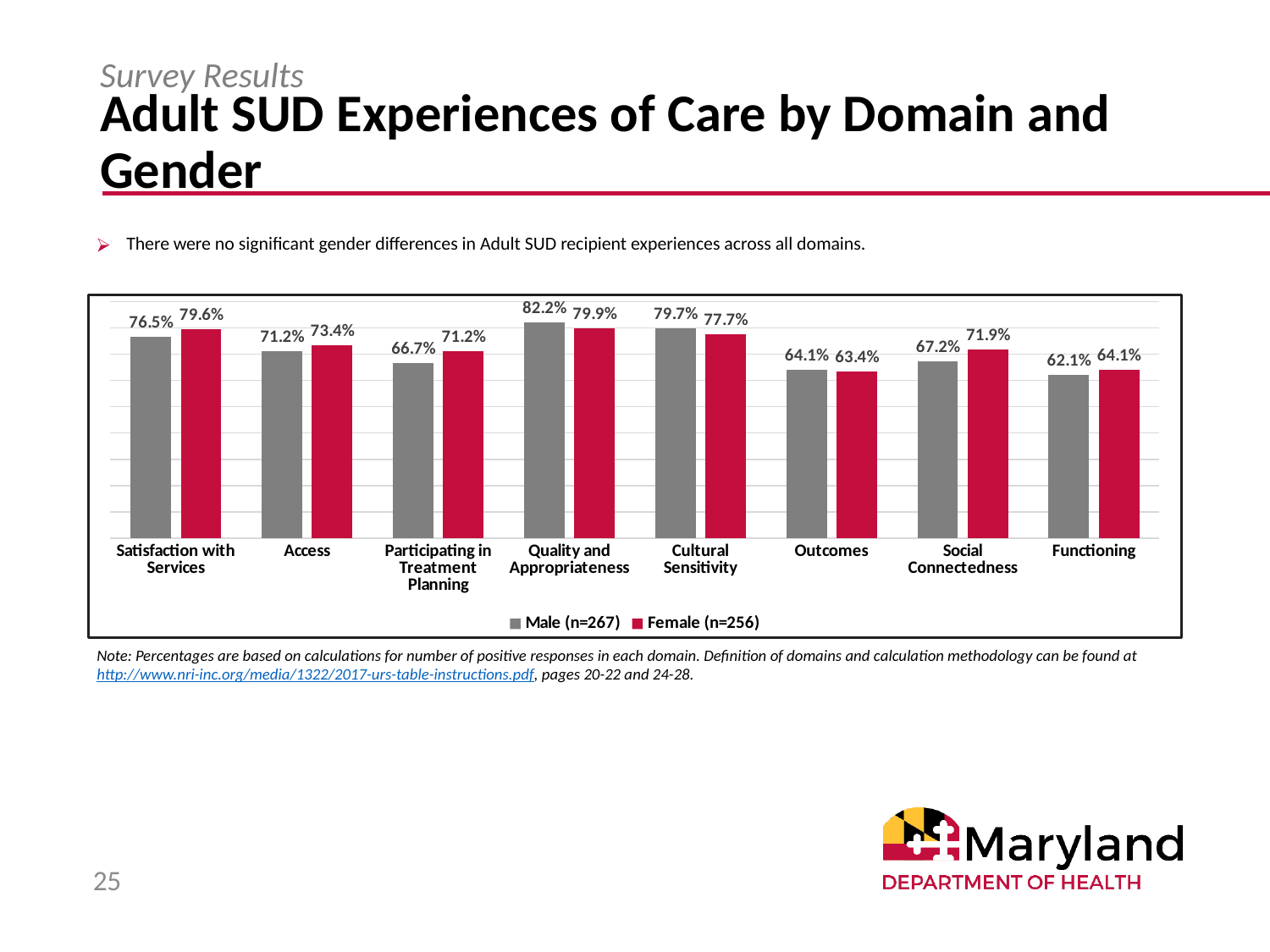
Which domain has the highest Male (n=267) value? Quality and Appropriateness What is the Female (n=256) value for Quality and Appropriateness? 79.9% What is the Male (n=267) value for Social Connectedness? 67.2% How many series does the chart legend list? 2 What is the Male (n=267) value for Satisfaction with Services? 76.5% Which domain has the lowest Female (n=256) value? Outcomes Which colour represents the Female (n=256) series in the chart? Red How many domains are shown on the x axis of the chart? 8 What is the difference between the Male (n=267) values for Quality and Appropriateness and Functioning? 20.1% What kind of chart is shown on the slide? Bar chart For Cultural Sensitivity, which is larger: the Male (n=267) value or the Female (n=256) value? Male (n=267) What is the difference between the Female (n=256) and Male (n=267) values for Participating in Treatment Planning? 4.5%